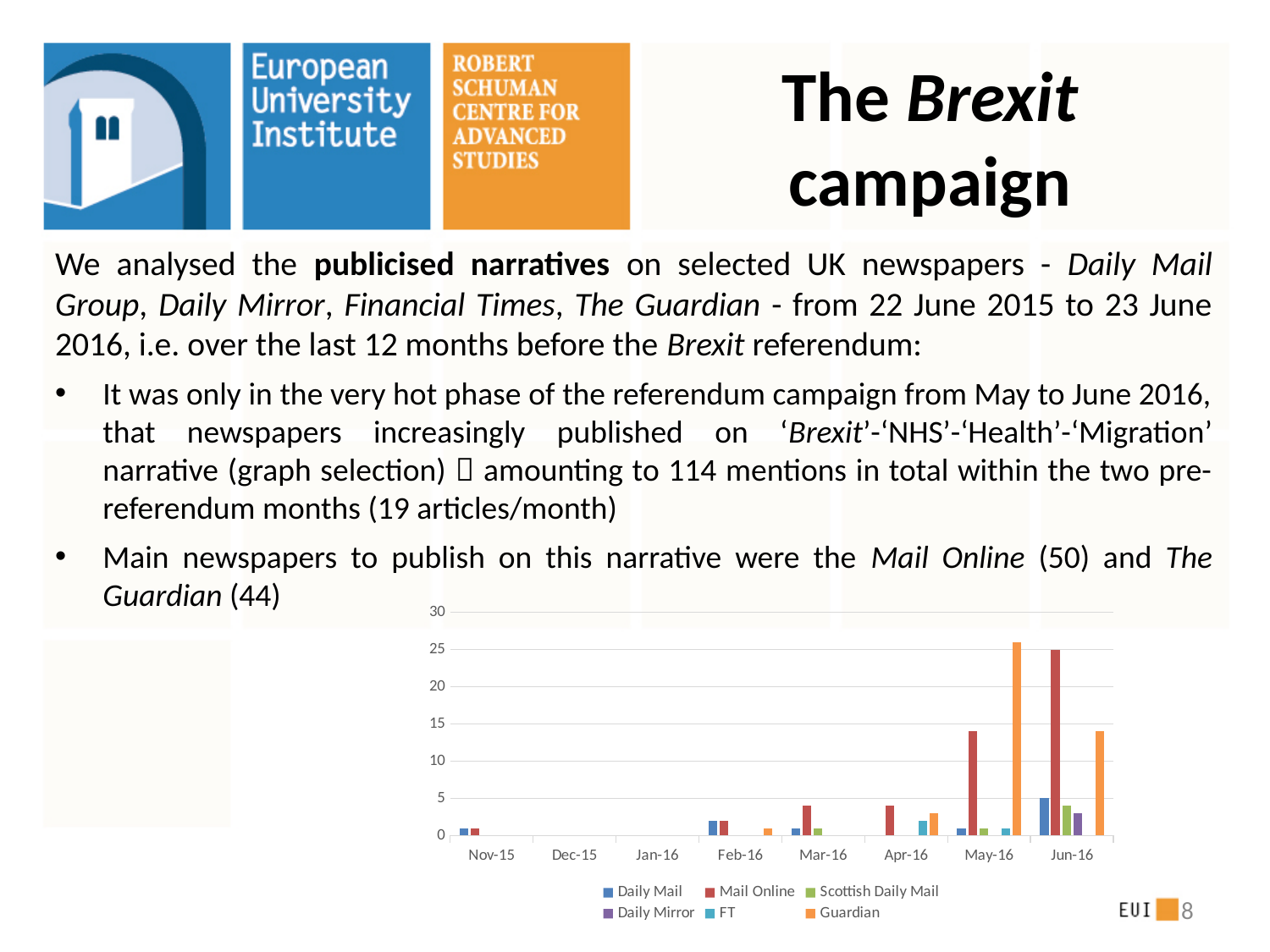
Is the value for Guardian in May-16 greater or less than 20? greater How many months are shown on the x axis of the chart? 8 Is the value for Mail Online in May-16 greater or less than 10? greater In May-16, which is larger: the value for Guardian or the value for Mail Online? Guardian What colour represents Guardian in the chart's legend? orange Does the value for Mail Online rise or fall from Apr-16 to Jun-16? rise What kind of chart is shown on the slide? bar chart Is the value for Daily Mail in Jun-16 greater or less than 10? less How many series does the chart's legend list? 6 In Jun-16, which is larger: the value for Mail Online or the value for Guardian? Mail Online Which series has the highest value in May-16? Guardian